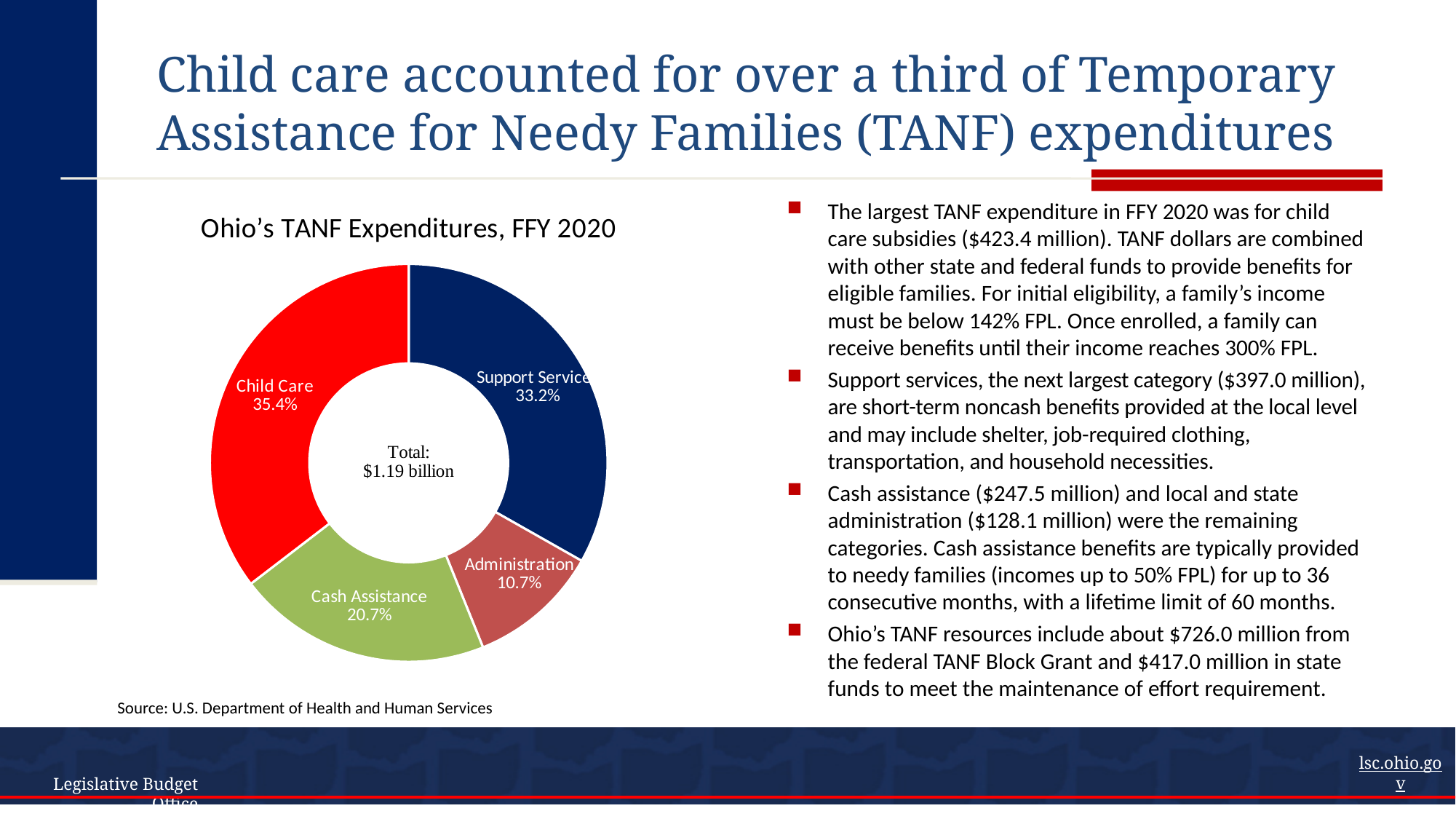
What total is printed in the center of the donut chart? $1.19 billion What percentage does the Administration slice represent? 10.7% What share of TANF expenditures is shown for Cash Assistance? 20.7% How many categories are shown in the donut chart? 4 Which is larger in the chart, Cash Assistance or Administration? Cash Assistance What percentage of the donut chart is Support Services? 33.2% Which category has the smallest share in the donut chart? Administration How many percentage points larger is the Child Care share than the Cash Assistance share? 14.7 What share of Ohio's TANF expenditures in FFY 2020 went to Child Care? 35.4% What type of chart is used to show Ohio's TANF expenditures? Donut (pie) chart What is the title of the chart on the slide? Ohio's TANF Expenditures, FFY 2020 Which category has the largest share of Ohio's TANF expenditures in the chart? Child Care